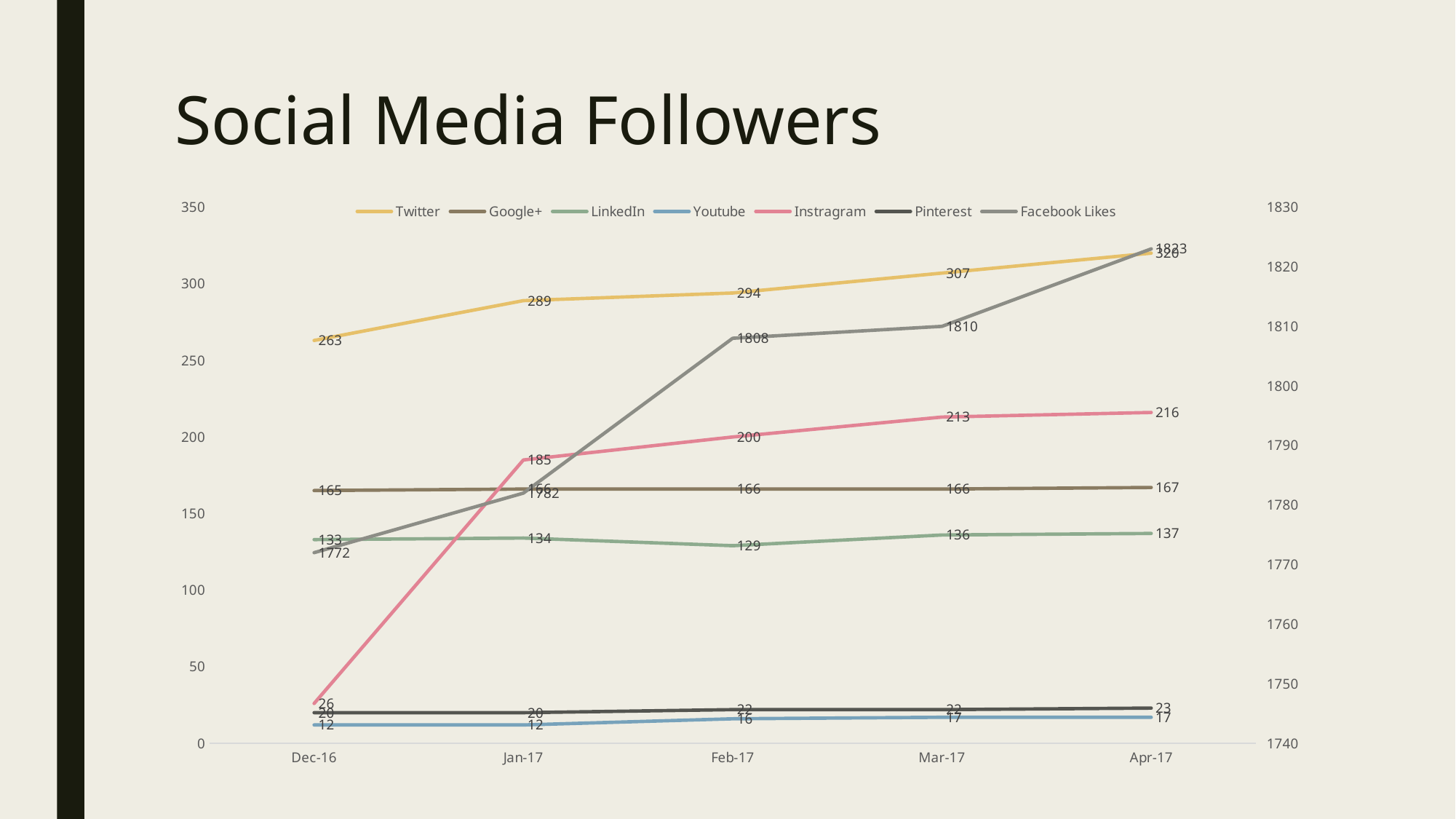
What is the value for LinkedIn in Feb-17? 129 What is the value for Twitter in Mar-17? 307 Which is larger in Mar-17, the Instragram value or the Google+ value? Instragram What is the value for Instragram in Feb-17? 200 What kind of chart is shown on the slide? line chart Do the Twitter values rise or fall from Dec-16 to Apr-17? rise What is the value for Facebook Likes in Feb-17? 1808 In which month is the Twitter value highest? Apr-17 What is the difference between the Twitter values for Jan-17 and Dec-16? 26 How many months are shown on the x axis? 5 In which month is the LinkedIn value lowest? Feb-17 How many series does the legend list? 7